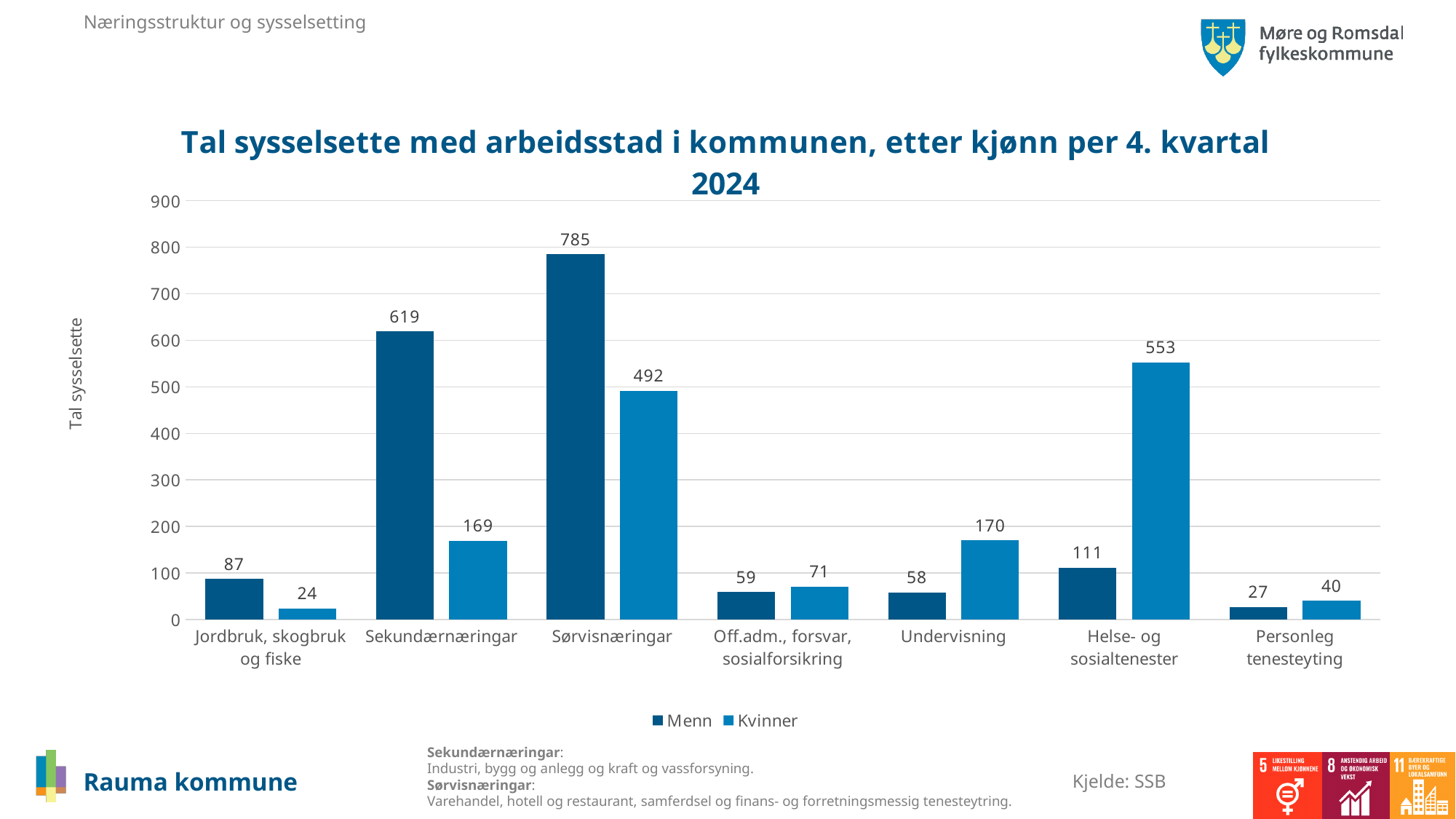
What is the difference between Menn and Kvinner in Sekundærnæringar? 450 What is the value for Kvinner in Jordbruk, skogbruk og fiske? 24 What kind of chart is shown on the slide? bar chart How many categories are shown on the x axis? 7 Is the value for Kvinner in Sørvisnæringar greater or less than 500? less Which category has the highest value for Menn? Sørvisnæringar What is the label of the y axis? Tal sysselsette Which category has the lowest value for Kvinner? Jordbruk, skogbruk og fiske How many series does the legend list? 2 What is the value for Menn in Sørvisnæringar? 785 What is the value for Kvinner in Helse- og sosialtenester? 553 Which is larger in Undervisning, Menn or Kvinner? Kvinner